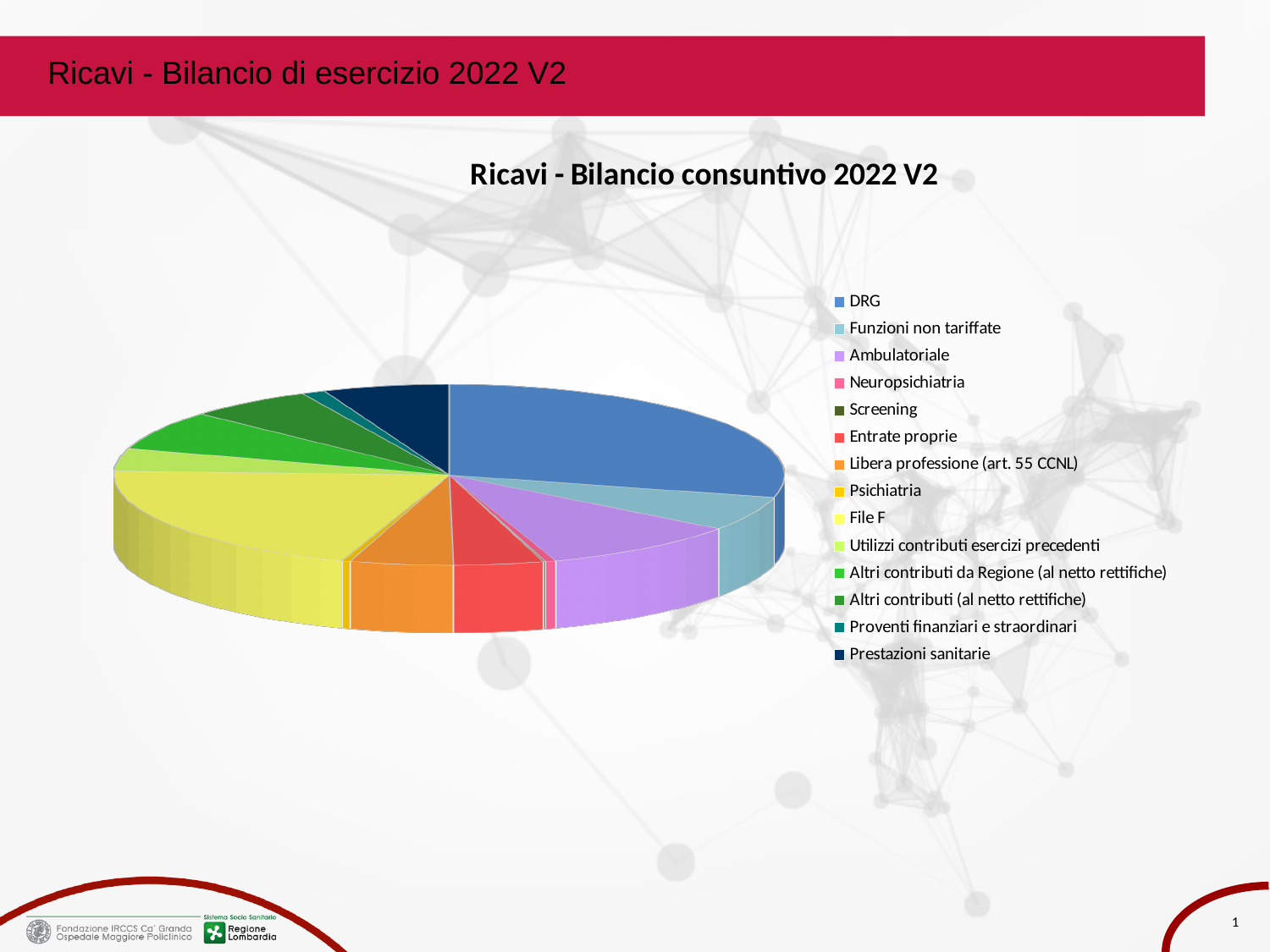
What is the title of the pie chart? Ricavi - Bilancio consuntivo 2022 V2 Which category has the largest slice of the pie chart? DRG Which slice is larger, Ambulatoriale or Neuropsichiatria? Ambulatoriale Which slice is larger, File F or Psichiatria? File F Which slice is larger, DRG or File F? DRG What kind of chart is shown on the slide? pie chart How many categories does the pie chart's legend list? 14 Which category is shown in yellow in the pie chart's legend? File F